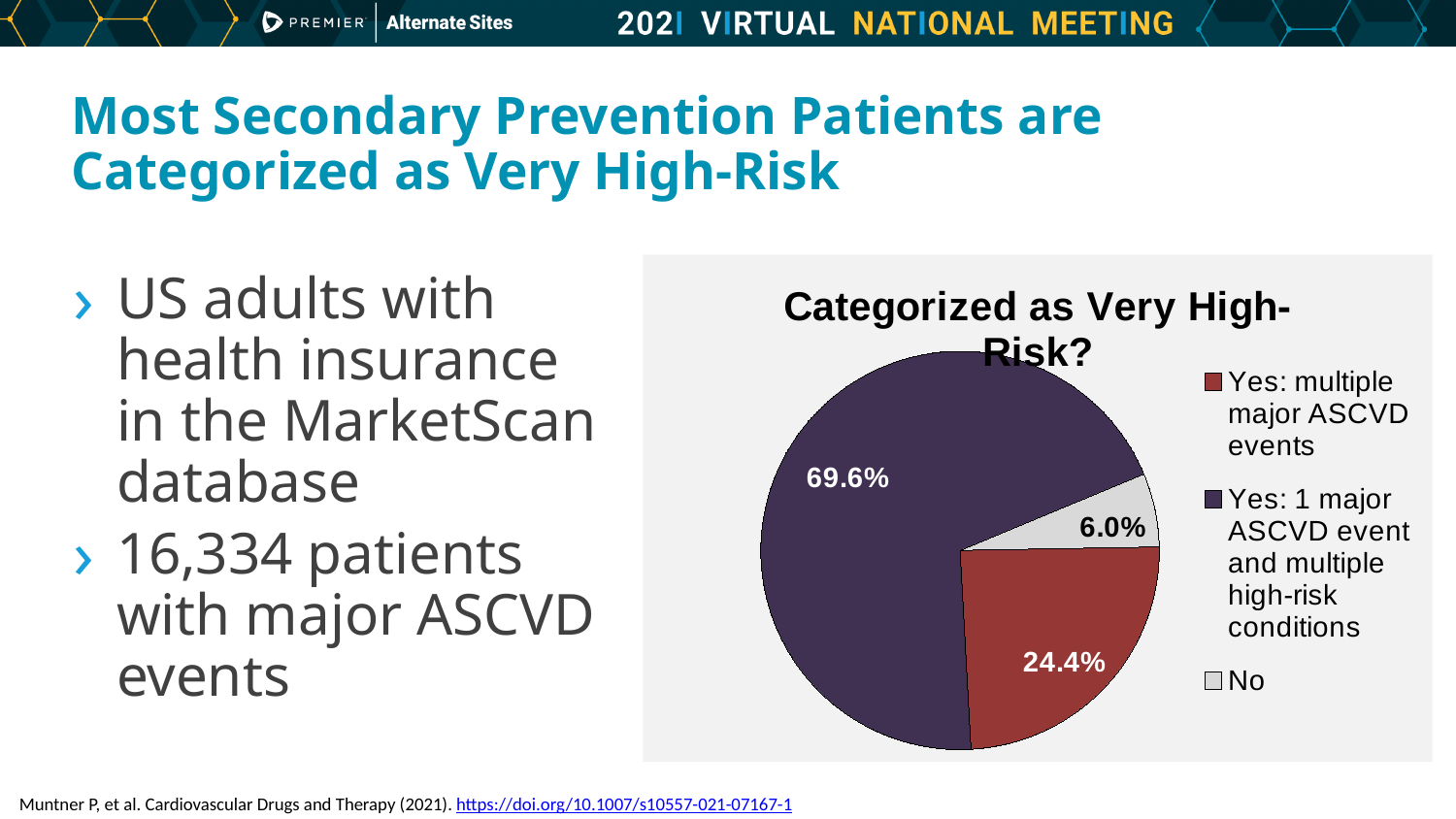
What colour is the slice for "No"? Light gray Which category has the largest slice of the pie? Yes: 1 major ASCVD event and multiple high-risk conditions What share of the pie is labelled "Yes: multiple major ASCVD events"? 24.4% How many entries does the legend list? 3 What share of the pie is labelled "Yes: 1 major ASCVD event and multiple high-risk conditions"? 69.6% How many slices does the pie chart have? 3 What share of the pie is labelled "No"? 6.0% What is the title of the chart? Categorized as Very High-Risk? What is the difference between the "Yes: 1 major ASCVD event and multiple high-risk conditions" slice and the "Yes: multiple major ASCVD events" slice? 45.2% What kind of chart is shown on the slide? Pie chart Which category has the smallest slice of the pie? No Which is larger: the "Yes: multiple major ASCVD events" slice or the "No" slice? Yes: multiple major ASCVD events